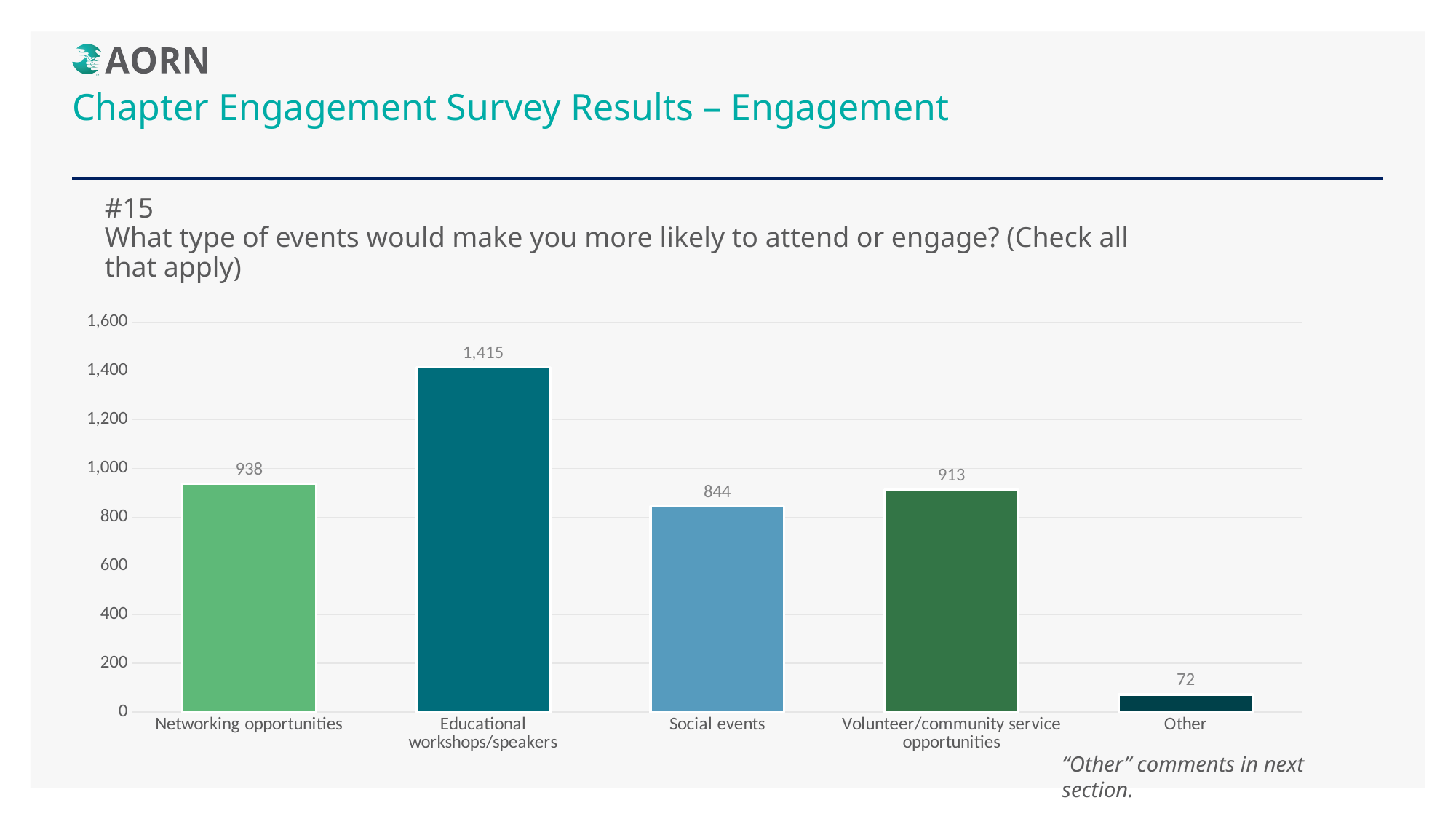
What is the value for Networking opportunities? 938 What is the value for Educational workshops/speakers? 1,415 Which category has the lowest value? Other Which is larger, the value for Networking opportunities or the value for Volunteer/community service opportunities? Networking opportunities What is the difference between the values for Educational workshops/speakers and Networking opportunities? 477 Which category has the highest value? Educational workshops/speakers What is the value for Social events? 844 What is the value for Other? 72 What kind of chart is shown on the slide? bar chart What is the value for Volunteer/community service opportunities? 913 Is the value for Social events greater or less than 1,000? less How many categories are shown in the chart? 5